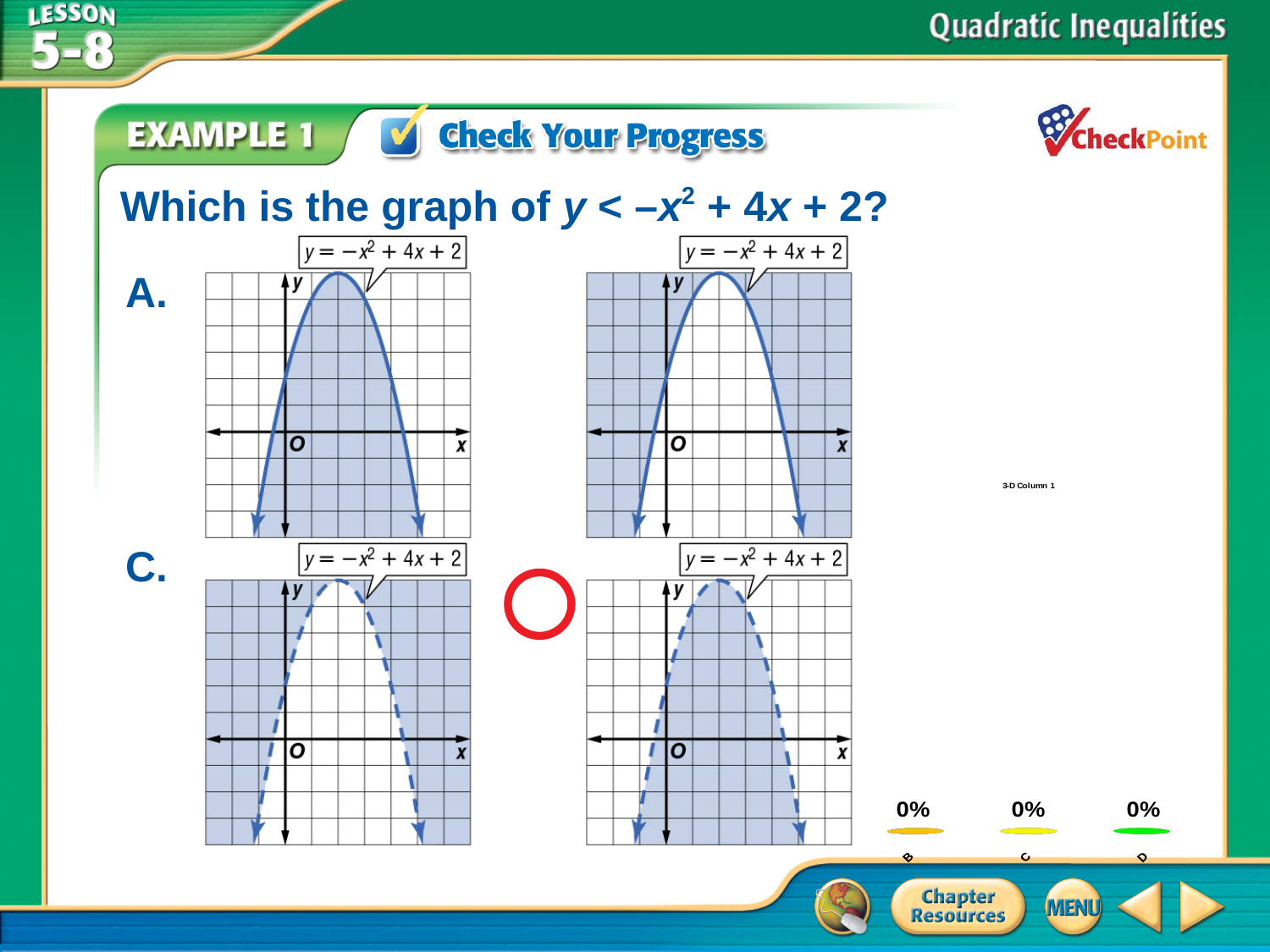
On the bar chart at the bottom right of the slide, what is the value shown for category D? 0% On the bar chart at the bottom right of the slide, what are the category labels along the x axis? B, C, D On the bar chart at the bottom right of the slide, what is the difference between the values for B and D? 0% How many categories are shown on the bar chart at the bottom right of the slide? 3 On the bar chart at the bottom right of the slide, what is the value shown for category C? 0% On the bar chart at the bottom right of the slide, do the values rise, fall, or stay the same from B to D? stay the same What kind of chart is the small chart at the bottom right of the slide? bar chart What is the title of the small chart at the bottom right of the slide? 3-D Column 1 On the bar chart at the bottom right of the slide, what is the value shown for category B? 0%